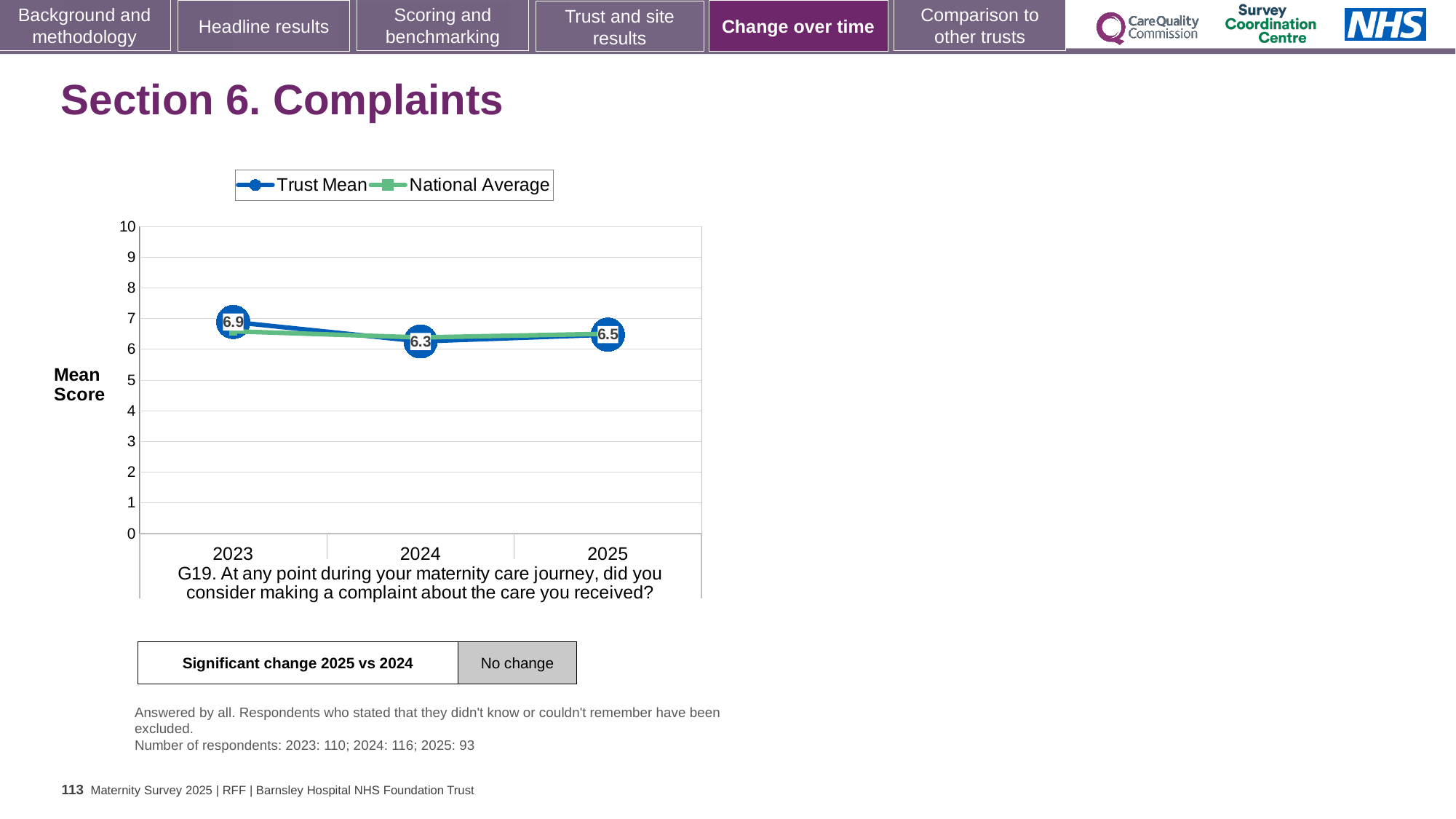
In 2023, which is larger: the Trust Mean or the National Average? Trust Mean What is the Trust Mean score for 2023? 6.9 How many series does the legend list? 2 How many years are plotted on the x axis? 3 What is the difference between the Trust Mean scores for 2025 and 2024? 0.2 Is the National Average value for 2023 greater or less than 6? greater In which year is the Trust Mean score highest? 2023 What is the Trust Mean score for 2025? 6.5 What is the Trust Mean score for 2024? 6.3 What is the difference between the Trust Mean scores for 2023 and 2024? 0.6 What kind of chart is shown on the slide? line chart In which year is the Trust Mean score lowest? 2024